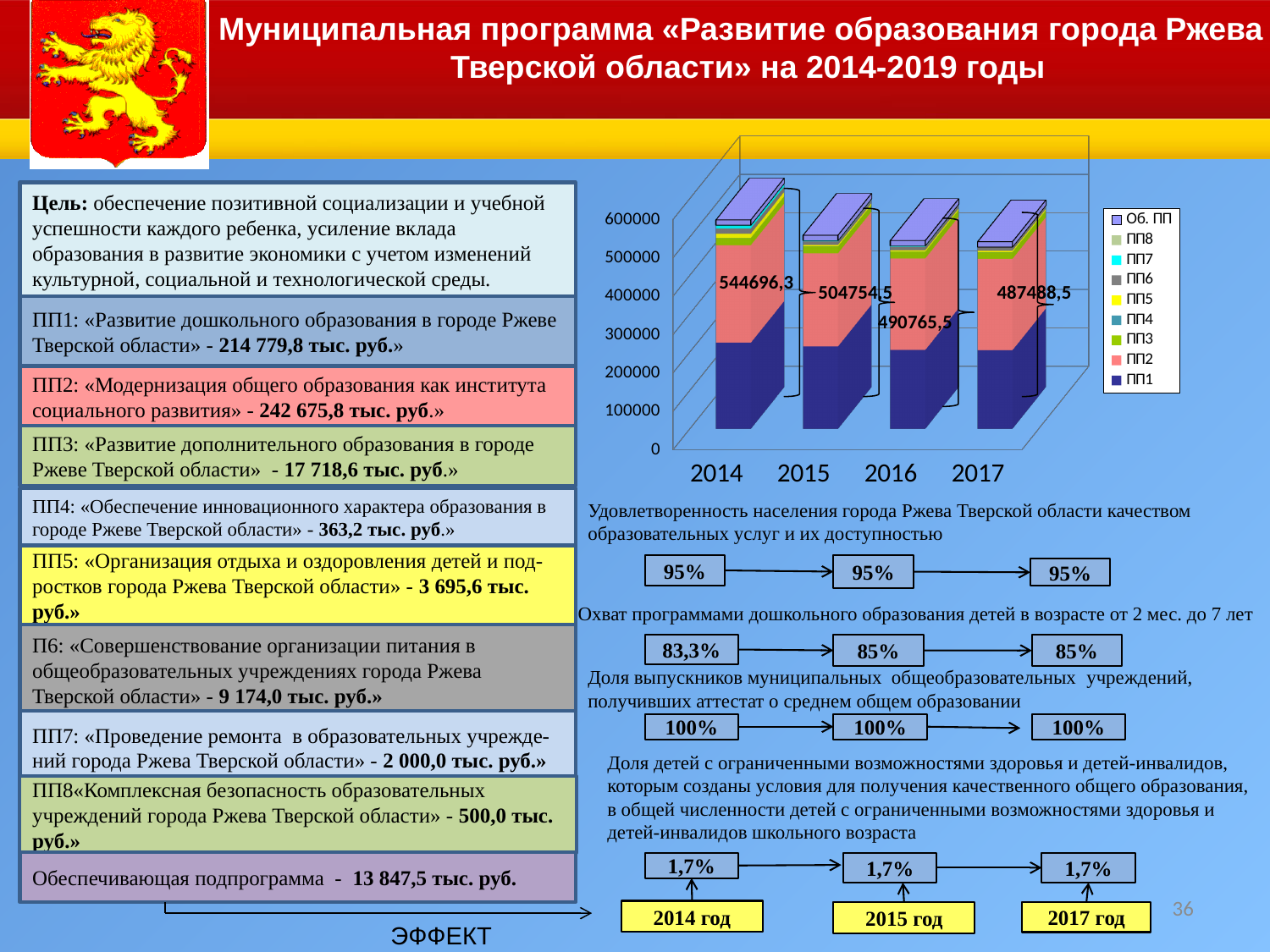
What is the difference between the labelled totals for 2014 and 2015? 39941,8 What is the total value labelled on the bar for 2017? 487488,5 Which year has the larger labelled total, 2015 or 2016? 2015 Which year has the lowest labelled total in the chart? 2017 What is the total value labelled on the bar for 2014? 544696,3 How many years are shown on the x axis of the chart? 4 How many series does the chart legend list? 9 Do the labelled totals rise or fall from 2014 to 2017? fall What kind of chart is shown on the slide? stacked bar chart What is the total value labelled on the bar for 2016? 490765,5 What is the difference between the labelled totals for 2014 and 2017? 57207,8 Which year has the highest labelled total in the chart? 2014